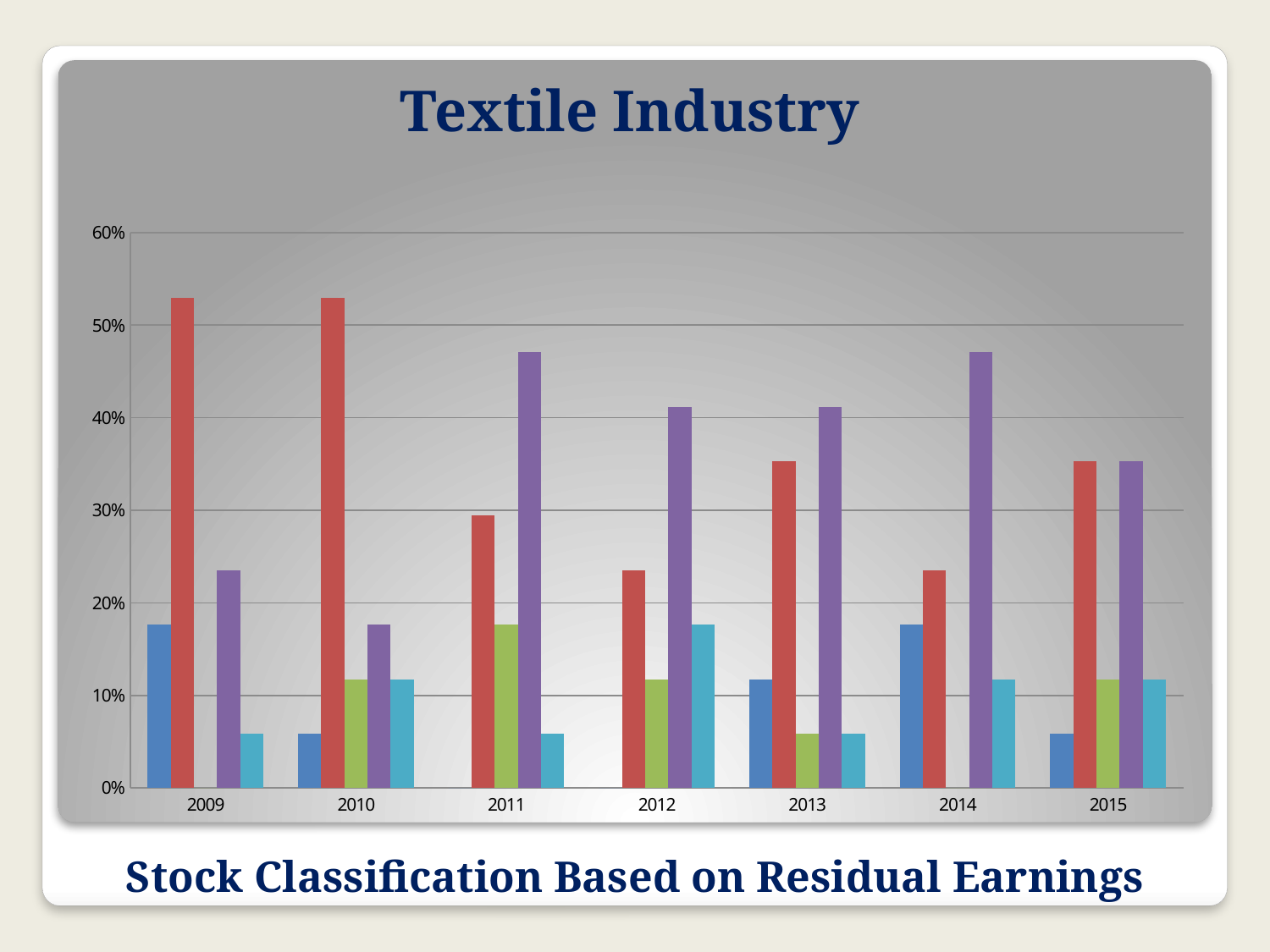
In 2009, which bar is taller, the red bar or the purple bar? the red bar Is the value of the red bar for 2013 greater or less than 30%? greater Is the value of the purple bar for 2014 greater or less than 50%? less What is the highest value shown on the vertical axis of the chart? 60% What is the title of the chart? Textile Industry Is the value of the purple bar for 2011 greater or less than 40%? greater How many years are shown on the x axis of the chart? 7 Is the blue bar taller in 2014 or in 2015? 2014 What kind of chart is shown on the slide? bar chart